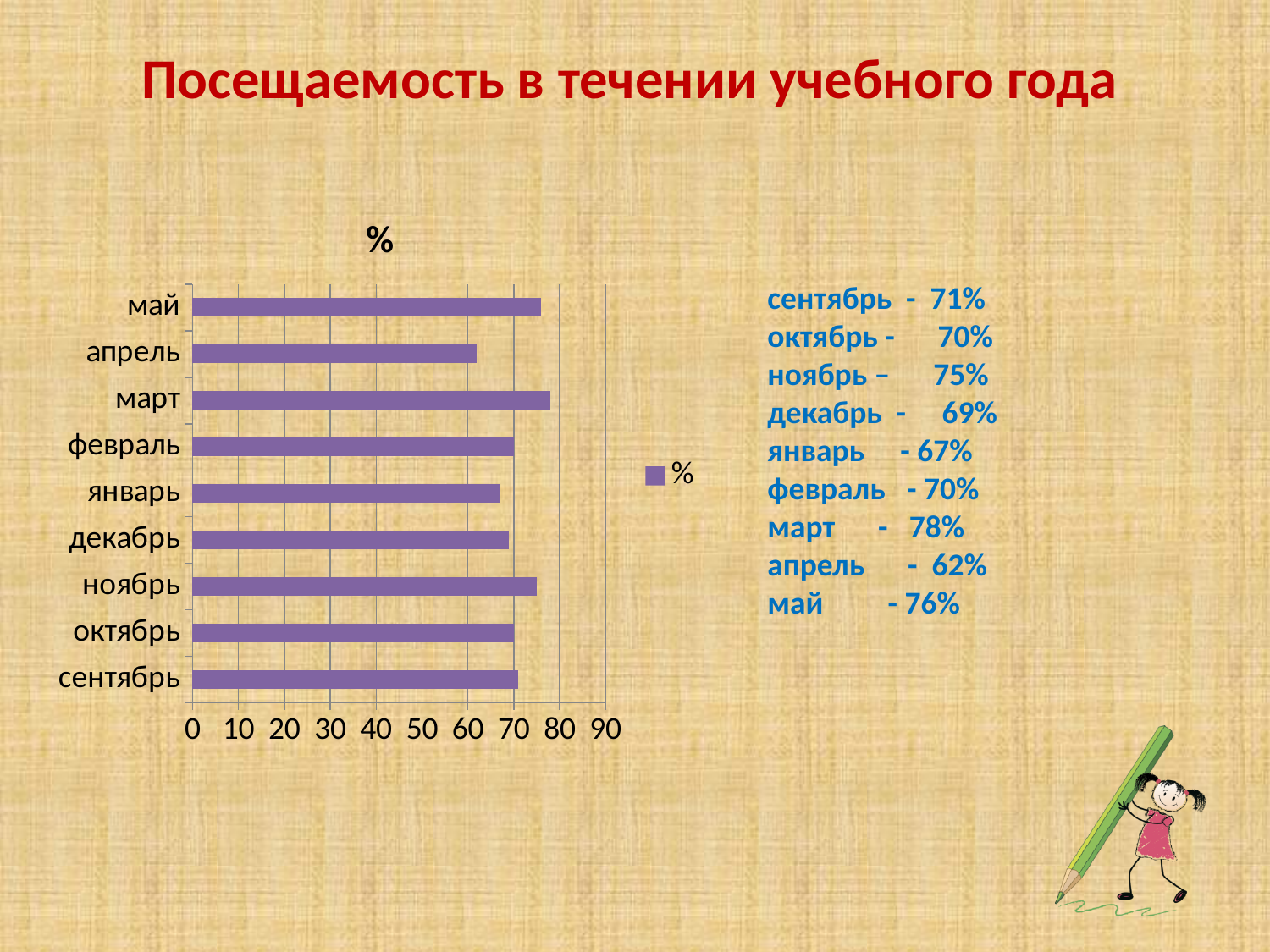
What is the attendance value for январь (January)? 67% What is the attendance value for апрель (April)? 62% What type of chart is shown on the slide? bar chart Is the value for апрель greater or less than 70? less Which month has the highest attendance? март Which month has the lowest attendance? апрель What is the attendance value for сентябрь (September)? 71% What is the attendance value for март (March)? 78% What is the difference between the attendance for март and апрель? 16% Which has the larger attendance value, май or апрель? май How many series does the legend list? 1 How many months are shown on the chart? 9